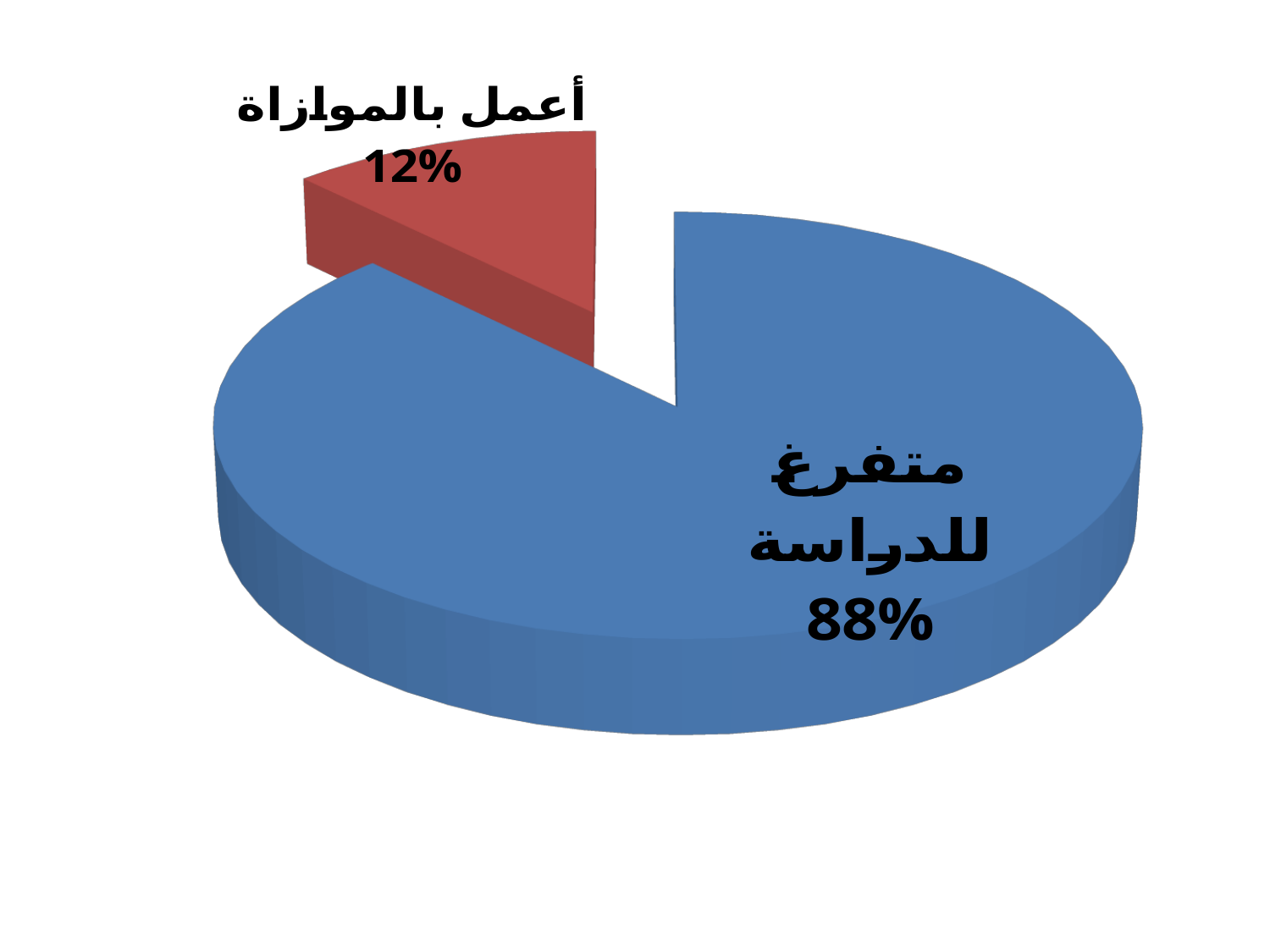
What percentage is shown for the slice labelled أعمل بالموازاة? 12% What colour is the slice labelled متفرغ للدراسة? blue Which slice of the pie is the smallest? أعمل بالموازاة What share of the pie does the أعمل بالموازاة slice represent? 12% Which slice of the pie is the largest? متفرغ للدراسة How many slices does the pie chart have? 2 What is the difference in percentage points between the متفرغ للدراسة slice and the أعمل بالموازاة slice? 76 What kind of chart is shown on the slide? pie chart What colour is the slice labelled أعمل بالموازاة? red Which is larger, the share for متفرغ للدراسة or the share for أعمل بالموازاة? متفرغ للدراسة What percentage is shown for the slice labelled متفرغ للدراسة? 88%